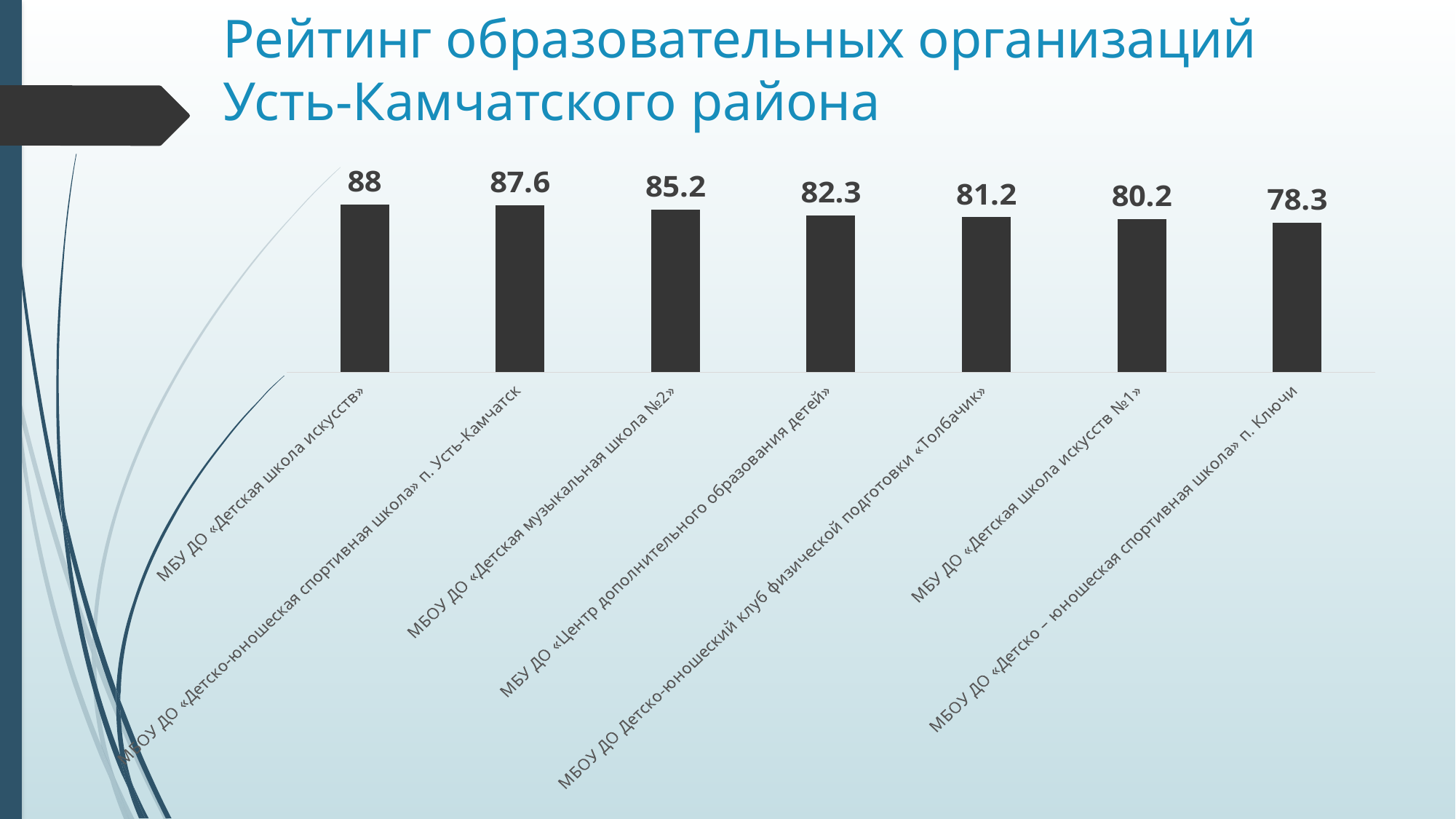
Which organisation has the lowest value? МБОУ ДО «Детско – юношеская спортивная школа» п. Ключи What is the difference between the values for МБУ ДО «Детская школа искусств» and МБОУ ДО «Детско – юношеская спортивная школа» п. Ключи? 9.7 Do the values rise or fall from left to right along the x axis? Fall What is the value for МБОУ ДО «Детско-юношеская спортивная школа» п. Усть-Камчатск? 87.6 What is the value for МБОУ ДО «Детско – юношеская спортивная школа» п. Ключи? 78.3 What is the value for МБУ ДО «Детская школа искусств»? 88 What is the value for МБУ ДО «Центр дополнительного образования детей»? 82.3 Which organisation has the highest value? МБУ ДО «Детская школа искусств» What kind of chart is shown on the slide? Bar chart How many organisations are shown in the chart? 7 Which has a larger value: МБУ ДО «Детская школа искусств №1» or МБОУ ДО Детско-юношеский клуб физической подготовки «Толбачик»? МБОУ ДО Детско-юношеский клуб физической подготовки «Толбачик» What is the value for МБОУ ДО «Детская музыкальная школа №2»? 85.2